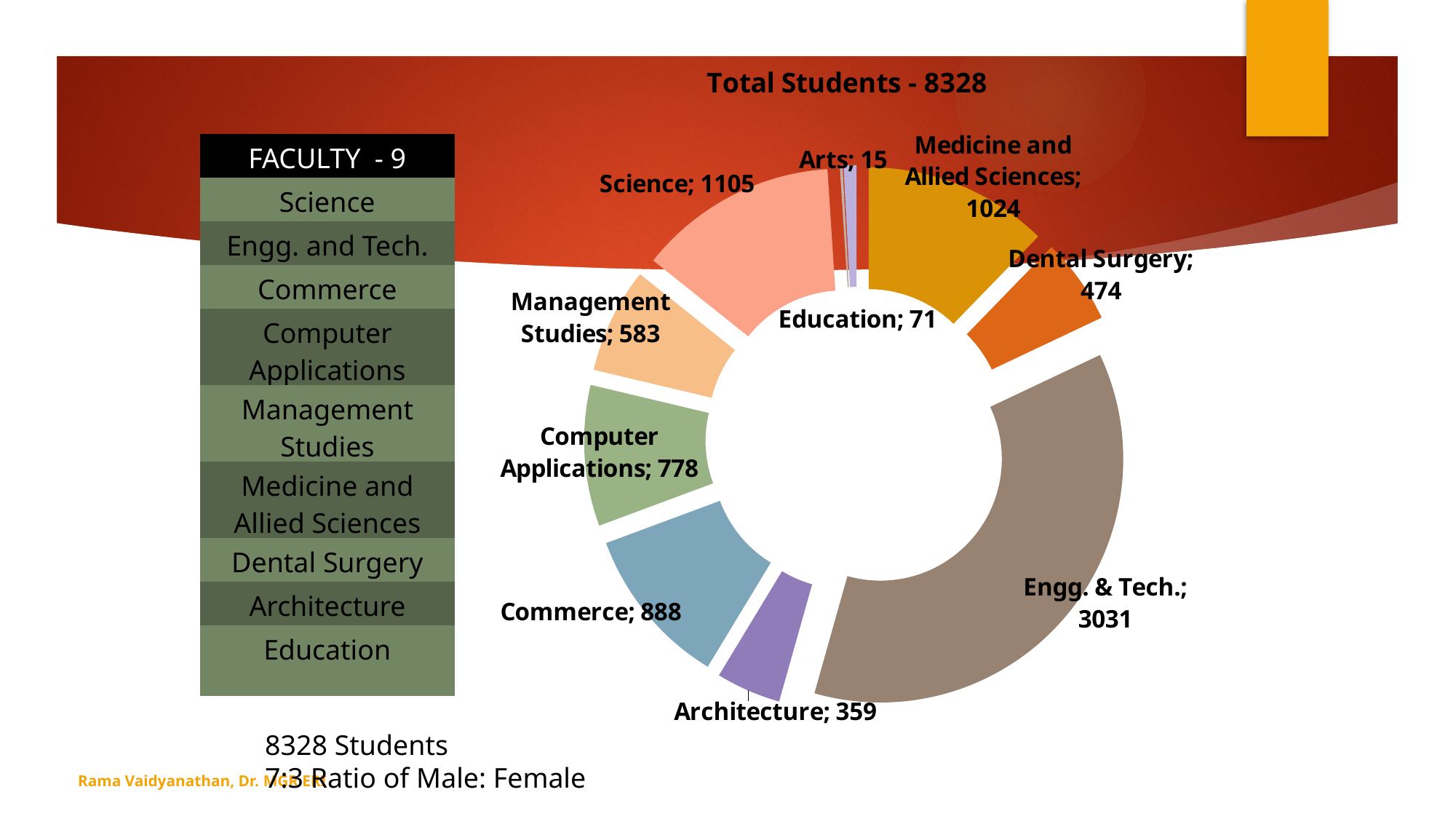
What is the difference between the Commerce and Education values? 817 Which faculty has the smallest number of students in the chart? Arts What is the value shown for Architecture? 359 How many categories (slices) does the chart show? 10 How many students are in Engg. & Tech. according to the chart? 3031 Which faculty has the largest number of students in the chart? Engg. & Tech. What is the difference between the Science and Computer Applications values? 327 Which is larger, Dental Surgery or Management Studies? Management Studies What type of chart is shown on the slide? doughnut chart What total number of students is stated in the chart title? 8328 What is the value shown for Medicine and Allied Sciences? 1024 What is the value shown for Commerce? 888